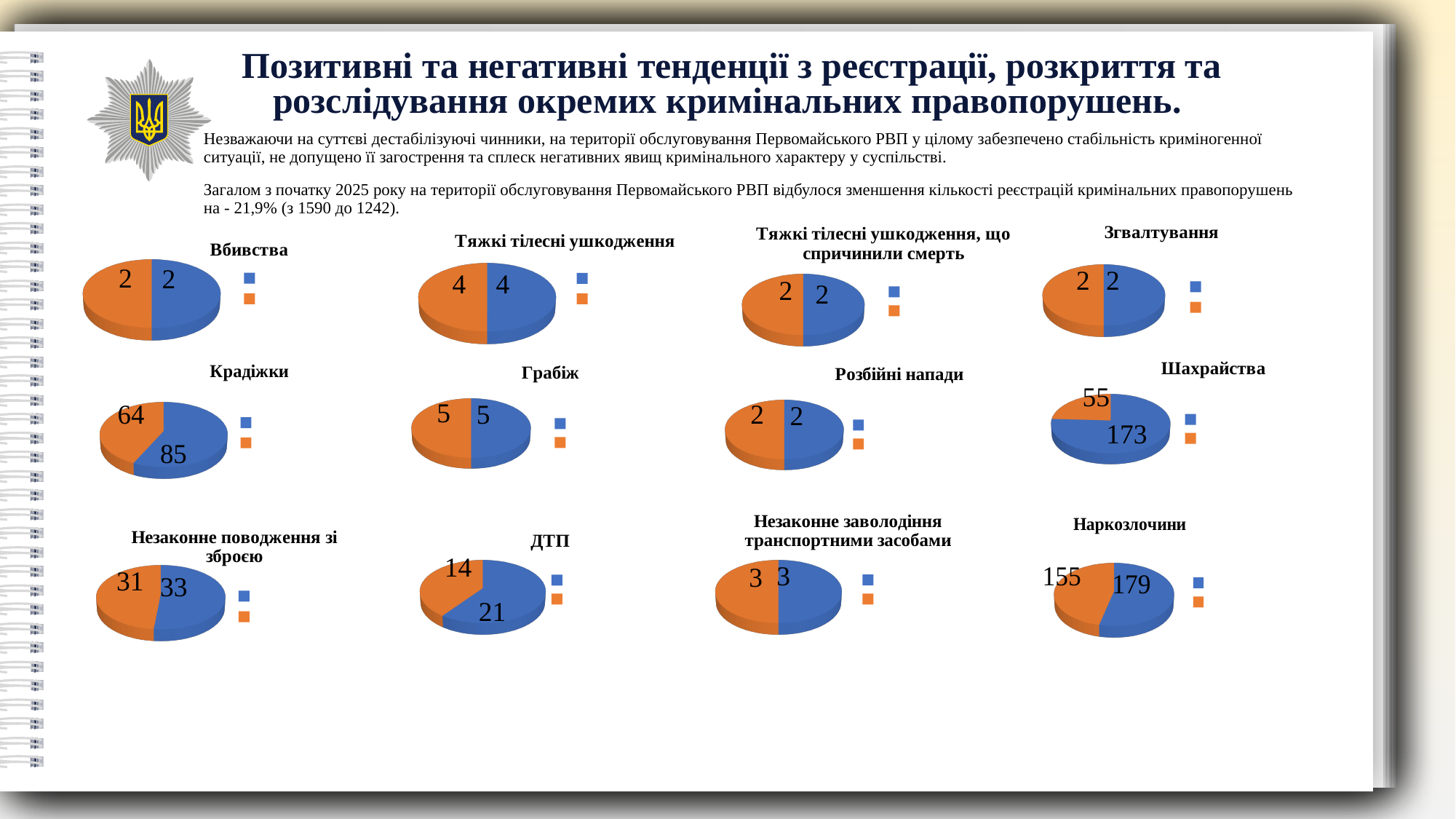
In the "Крадіжки" pie chart, what value is shown for the blue slice? 85 In the "Крадіжки" pie chart, which slice is larger, the blue one or the orange one? blue In the "ДТП" pie chart, what is the difference between the blue slice value and the orange slice value? 7 In the "Шахрайства" pie chart, what value is shown for the orange slice? 55 In the "Наркозлочини" pie chart, what is the total of the two slice values? 334 In the "Незаконне поводження зі зброєю" pie chart, what is the difference between the blue and orange slice values? 2 In the "Шахрайства" pie chart, what is the total of the two slice values? 228 How many slices does the "Незаконне заволодіння транспортними засобами" pie chart have? 2 What kind of chart is used for "Грабіж"? pie chart In the "Тяжкі тілесні ушкодження" pie chart, what value is shown for the orange slice? 4 In the "Наркозлочини" pie chart, what value is shown for the blue slice? 179 How many pie charts are shown on the slide? 12